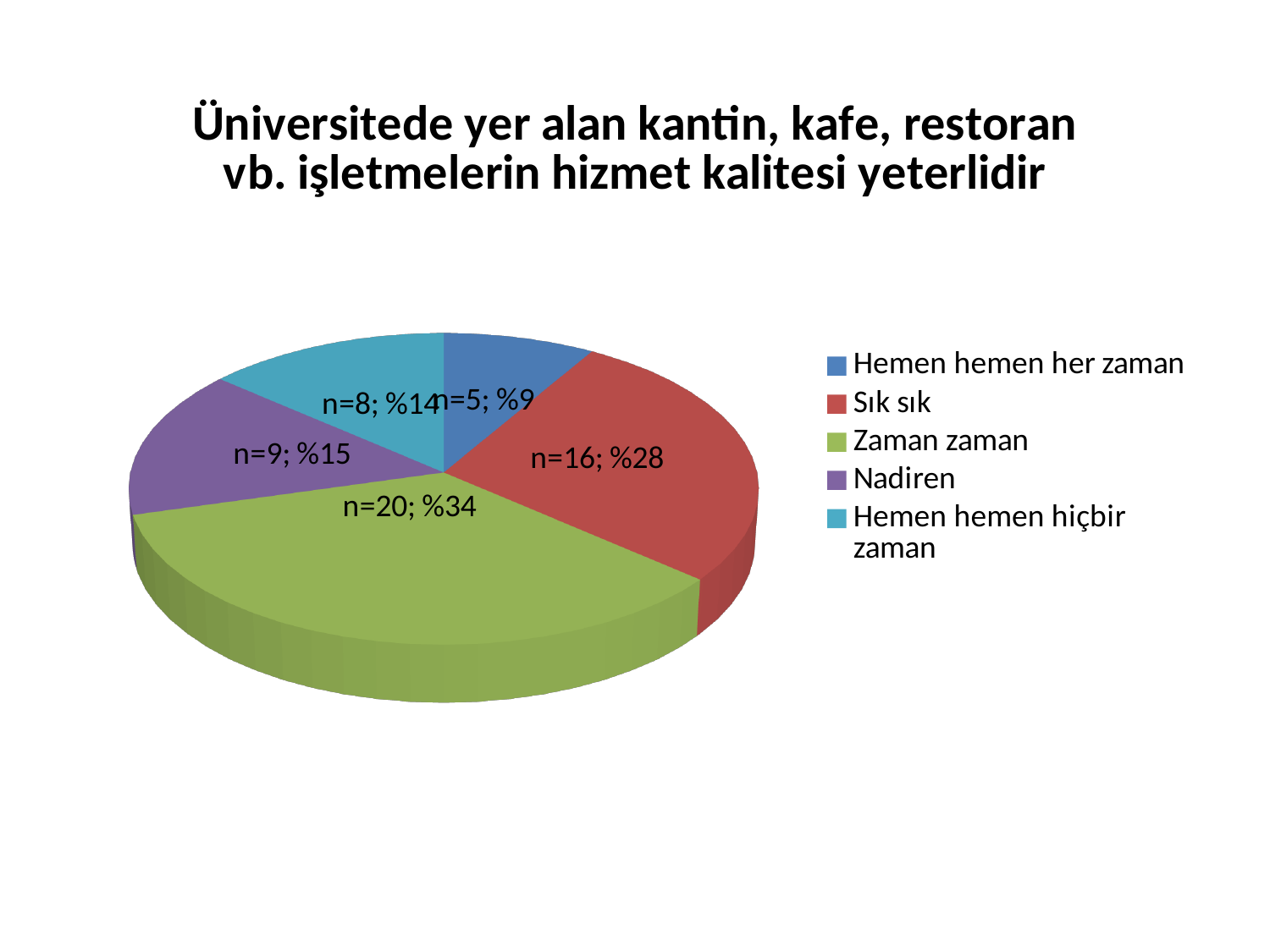
Which category has the largest slice of the pie? Zaman zaman What is the difference in count (n) between 'Zaman zaman' and 'Sık sık'? 4 Which category has the smallest slice of the pie? Hemen hemen her zaman What colour is the 'Zaman zaman' slice? green What percentage share does the 'Sık sık' slice have? %28 How many slices does the pie chart have? 5 What is the count (n) for the 'Hemen hemen her zaman' slice? n=5 What is the count (n) for the 'Hemen hemen hiçbir zaman' slice? n=8 What percentage share does the 'Nadiren' slice have? %15 What is the count (n) for the 'Zaman zaman' slice? n=20 What kind of chart is shown on the slide? pie chart Which has a larger count, 'Nadiren' or 'Hemen hemen hiçbir zaman'? Nadiren